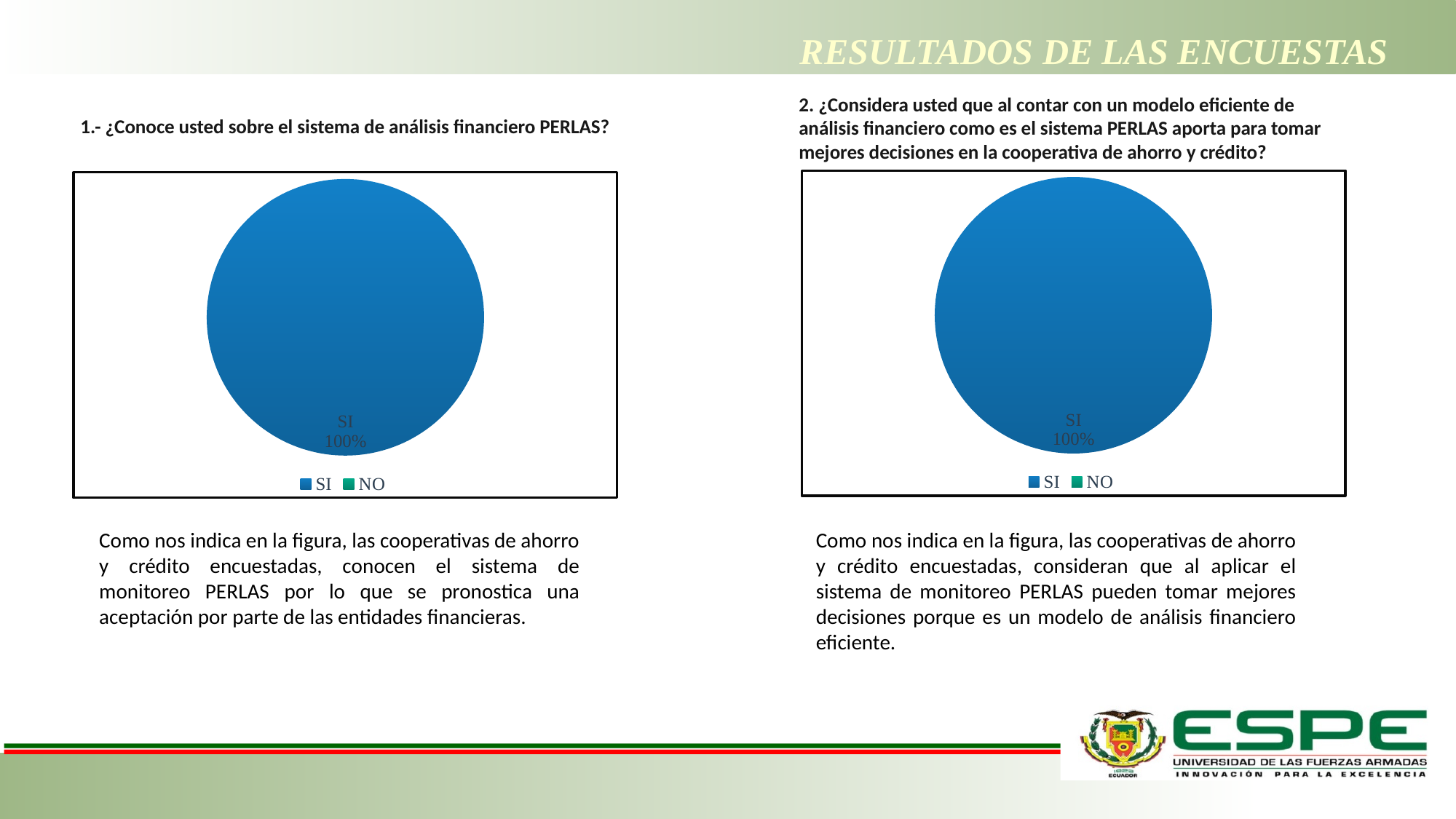
In the left chart (question 1), what share of the pie is labelled SI? 100% How many entries does the legend of the right chart (question 2) list? 2 In the left chart (question 1), which category has the largest share? SI What kind of chart is the left chart (question 1)? Pie chart In the right chart (question 2), which is larger, the share for SI or the share for NO? SI What kind of chart is the right chart (question 2)? Pie chart In the right chart (question 2), what share of the pie is labelled SI? 100% In the left chart (question 1), which is larger, the share for SI or the share for NO? SI In the right chart (question 2), which category has the largest share? SI How many entries does the legend of the left chart (question 1) list? 2 What are the two legend entries in the left chart (question 1)? SI and NO What colour is the SI slice in the right chart (question 2)? Blue